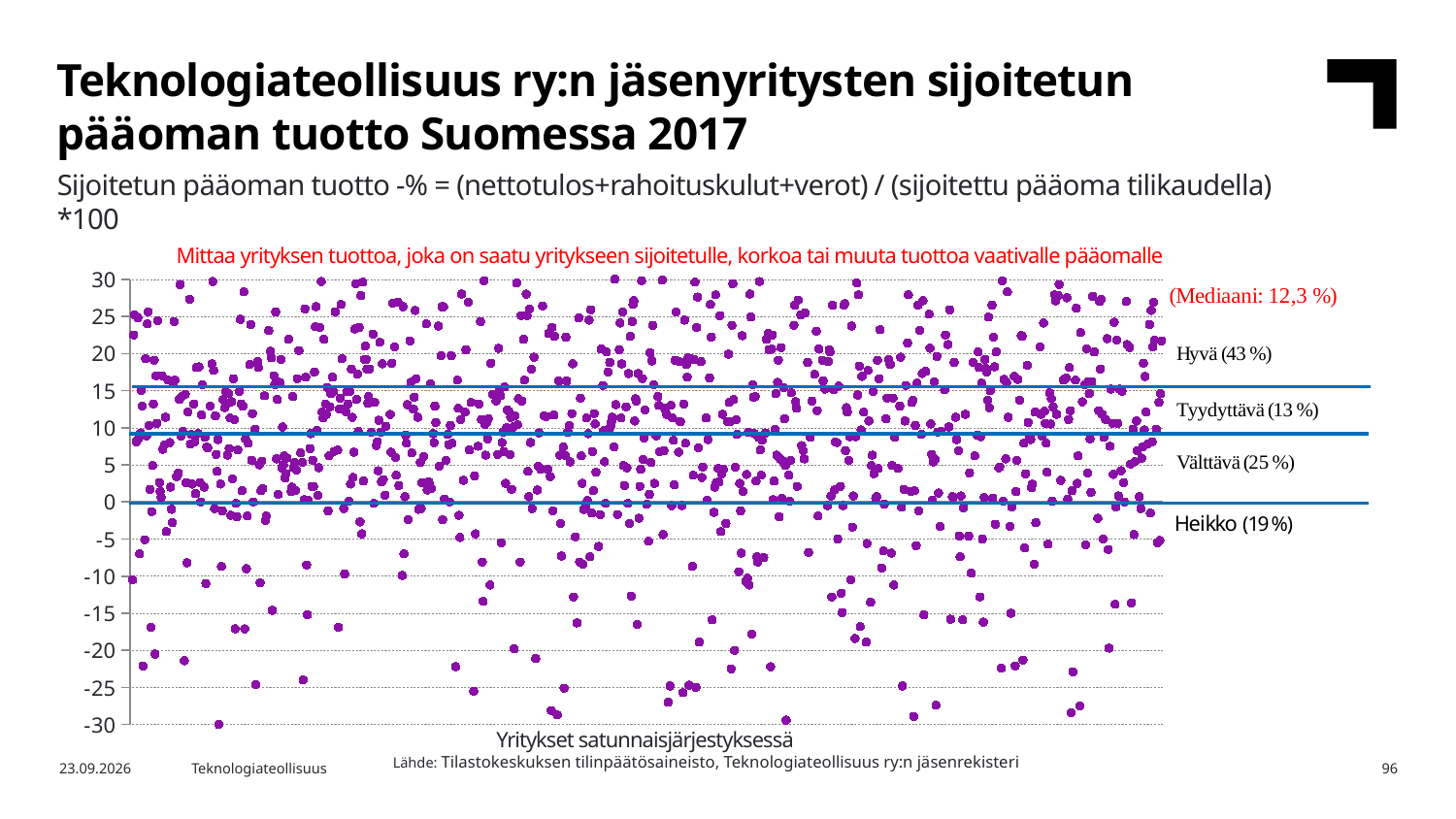
How many categories (Hyvä, Tyydyttävä, Välttävä, Heikko) are labelled on the chart? 4 What share of companies falls into the Heikko category? 19 % What is the label of the x axis? Yritykset satunnaisjärjestyksessä Which category has the smallest share of companies? Tyydyttävä What share of companies falls into the Välttävä category? 25 % What is the median return on invested capital (Mediaani) shown on the chart? 12,3 % What is the difference in percentage points between the Hyvä share and the Heikko share? 24 What share of companies falls into the Tyydyttävä category? 13 % Which category has the largest share of companies? Hyvä What kind of chart is shown on the slide? scatter chart Which category has a larger share, Välttävä or Heikko? Välttävä What share of companies falls into the Hyvä category? 43 %